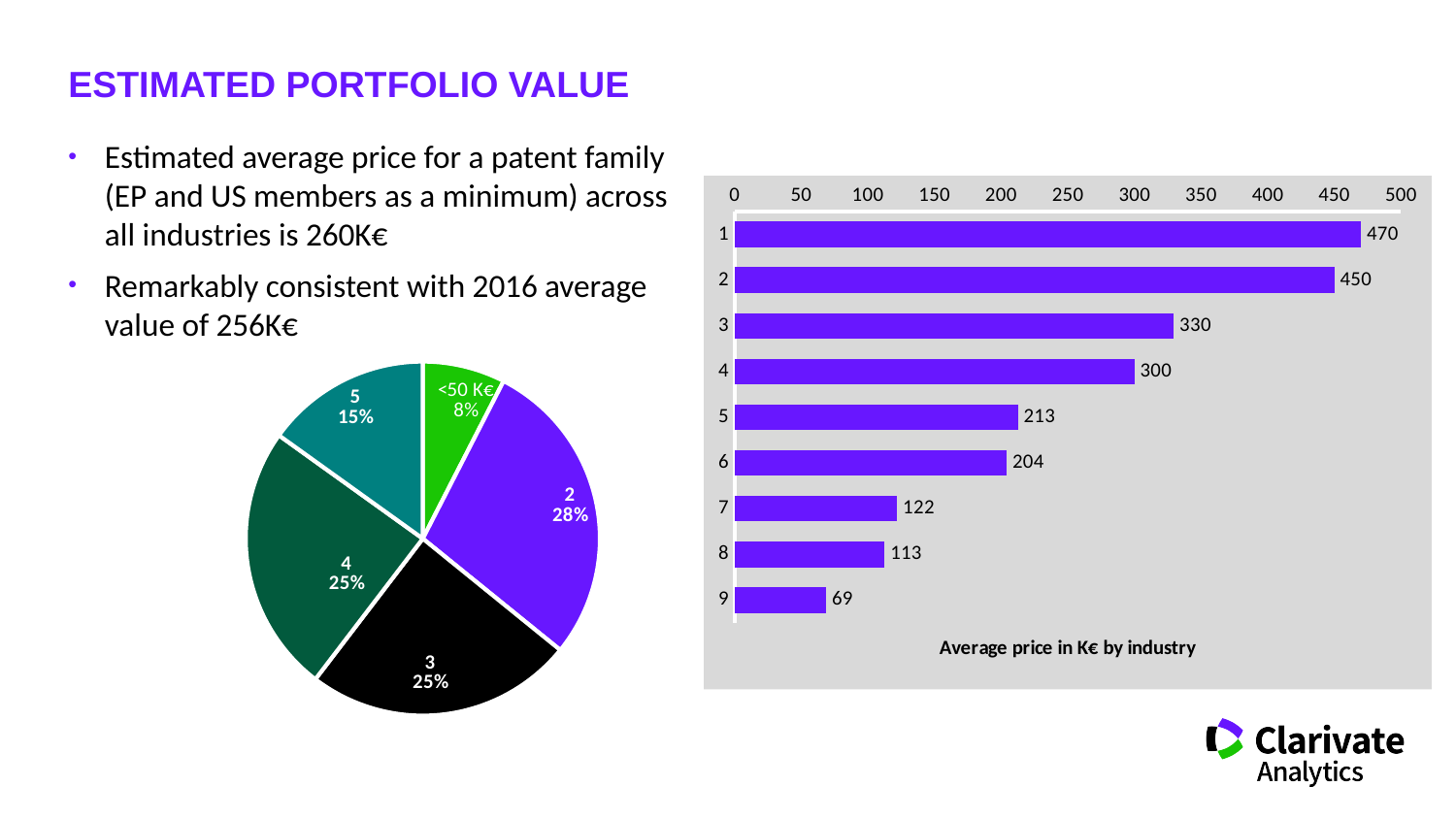
How many slices does the pie chart on the left of the slide have? 5 In the bar chart titled 'Average price in K€ by industry', how many industries are plotted? 9 In the bar chart titled 'Average price in K€ by industry', what is the value for industry 1? 470 In the bar chart titled 'Average price in K€ by industry', which is larger, the value for industry 7 or industry 8? 7 In the pie chart on the left of the slide, what share does the '<50 K€' slice have? 8% In the pie chart on the left of the slide, what share does slice 2 have? 28% In the bar chart titled 'Average price in K€ by industry', which industry has the lowest value? 9 In the bar chart titled 'Average price in K€ by industry', which industry has the highest value? 1 In the bar chart titled 'Average price in K€ by industry', do the values rise or fall going from industry 1 down to industry 9? fall In the bar chart titled 'Average price in K€ by industry', what is the difference between the values for industry 3 and industry 4? 30 In the bar chart titled 'Average price in K€ by industry', what is the value for industry 6? 204 What kind of chart is the chart titled 'Average price in K€ by industry'? bar chart